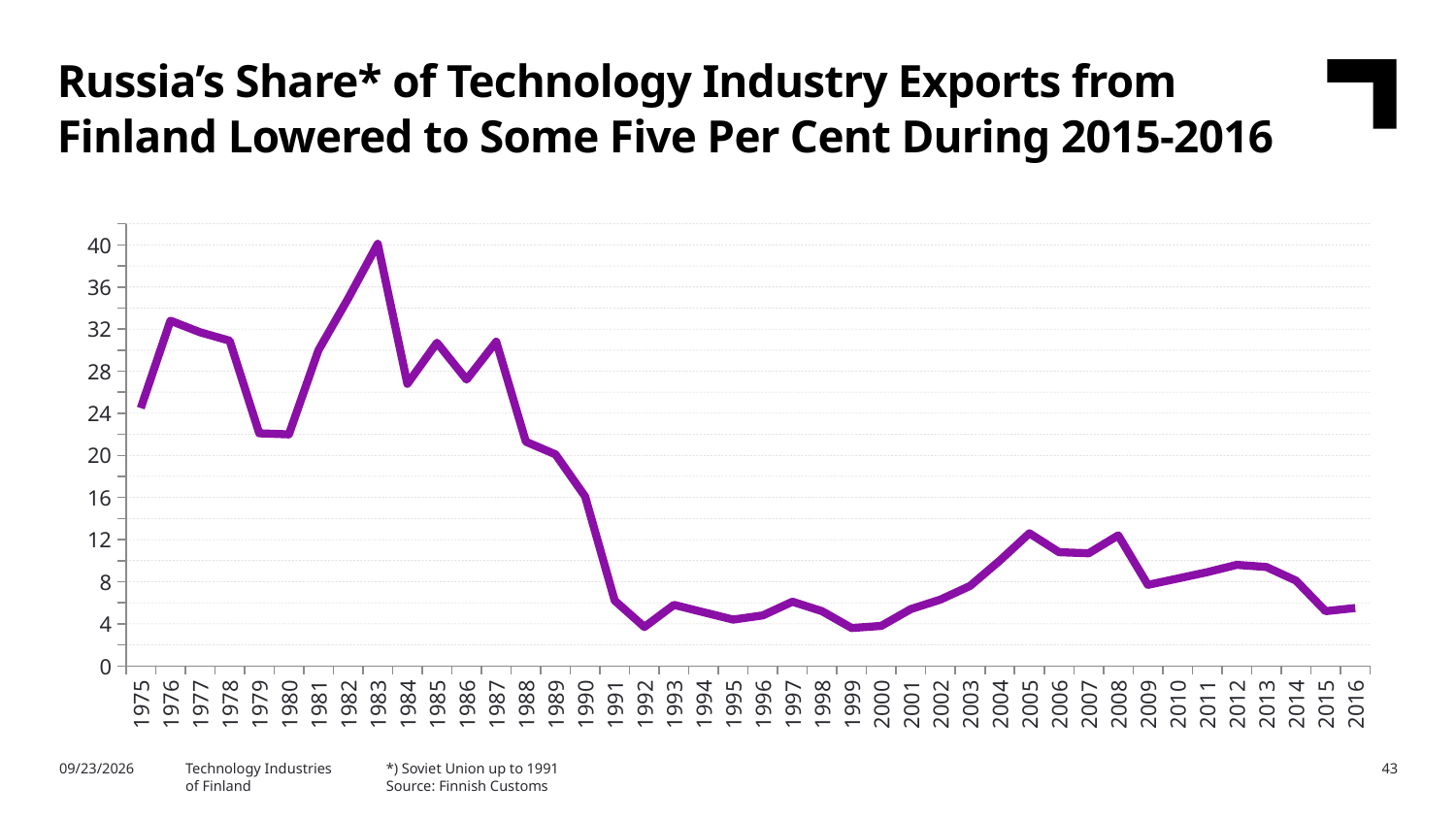
Is the value for 1976 greater or less than 28? greater Is the value for 1983 greater or less than 36? greater How many years are plotted on the x axis? 42 According to the footnote, what does the asterisk in the title refer to? Soviet Union up to 1991 Does the value rise or fall between 1983 and 1992? Fall Is the value for 2009 greater or less than 12? less Which year has the highest value on the chart? 1983 Which year has the larger value, 2005 or 2015? 2005 Which year has the larger value, 1983 or 1990? 1983 What kind of chart is shown on the slide? Line chart